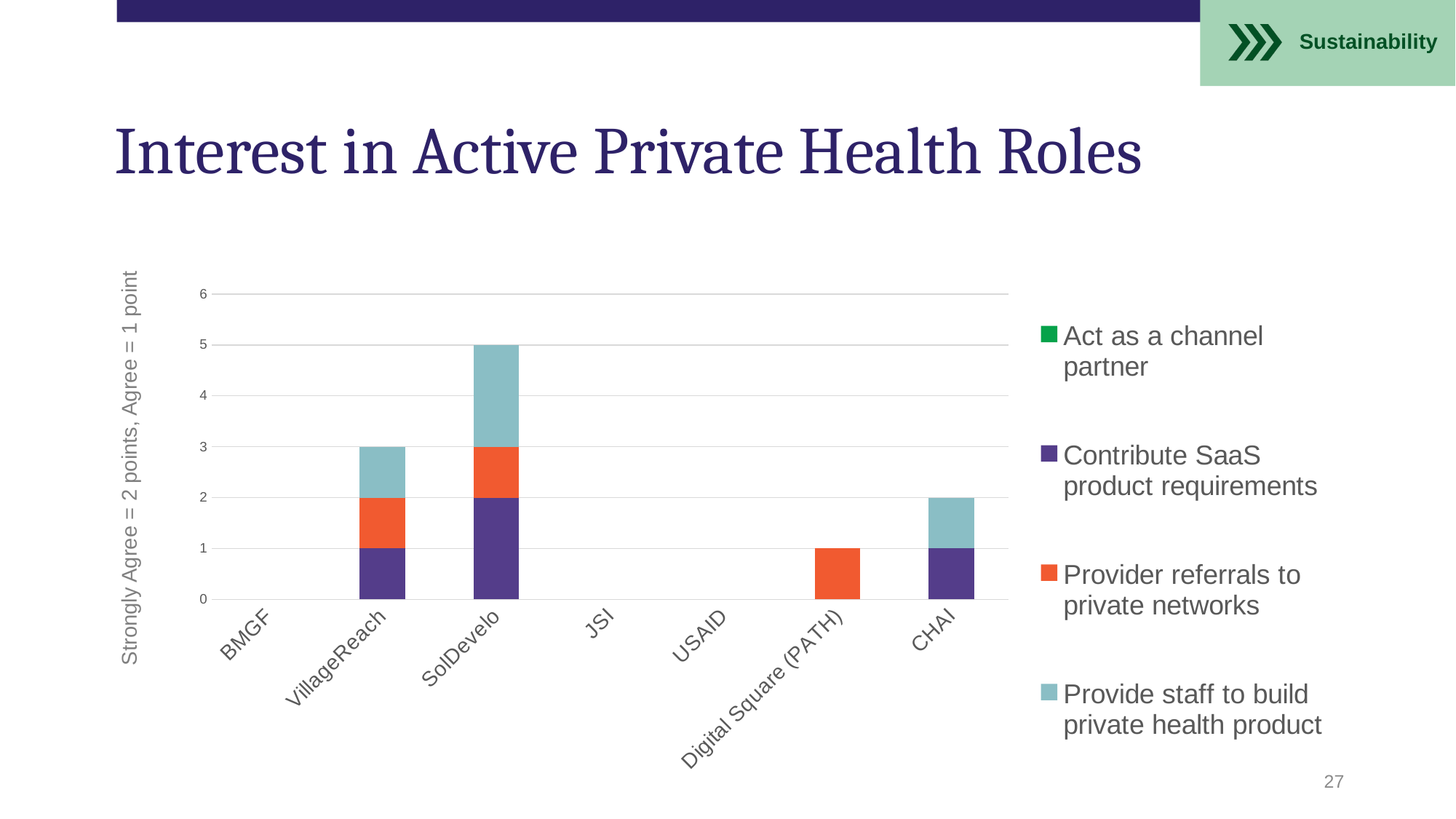
What is the total height of the stacked bar for CHAI? 2 What is the title of the chart on the slide? Interest in Active Private Health Roles What is the total height of the stacked bar for VillageReach? 3 How many organizations are listed along the x axis of the chart? 7 What is the total height of the stacked bar for SolDevelo? 5 What is the value of the 'Provider referrals to private networks' segment for Digital Square (PATH)? 1 How many series does the chart's legend list? 4 What is the value of the 'Contribute SaaS product requirements' segment for SolDevelo? 2 Which organization has the tallest stacked bar in the chart? SolDevelo What kind of chart is shown on the slide? Stacked bar chart Which has a taller stacked bar, VillageReach or CHAI? VillageReach What is the difference between the total bar heights of SolDevelo and VillageReach? 2